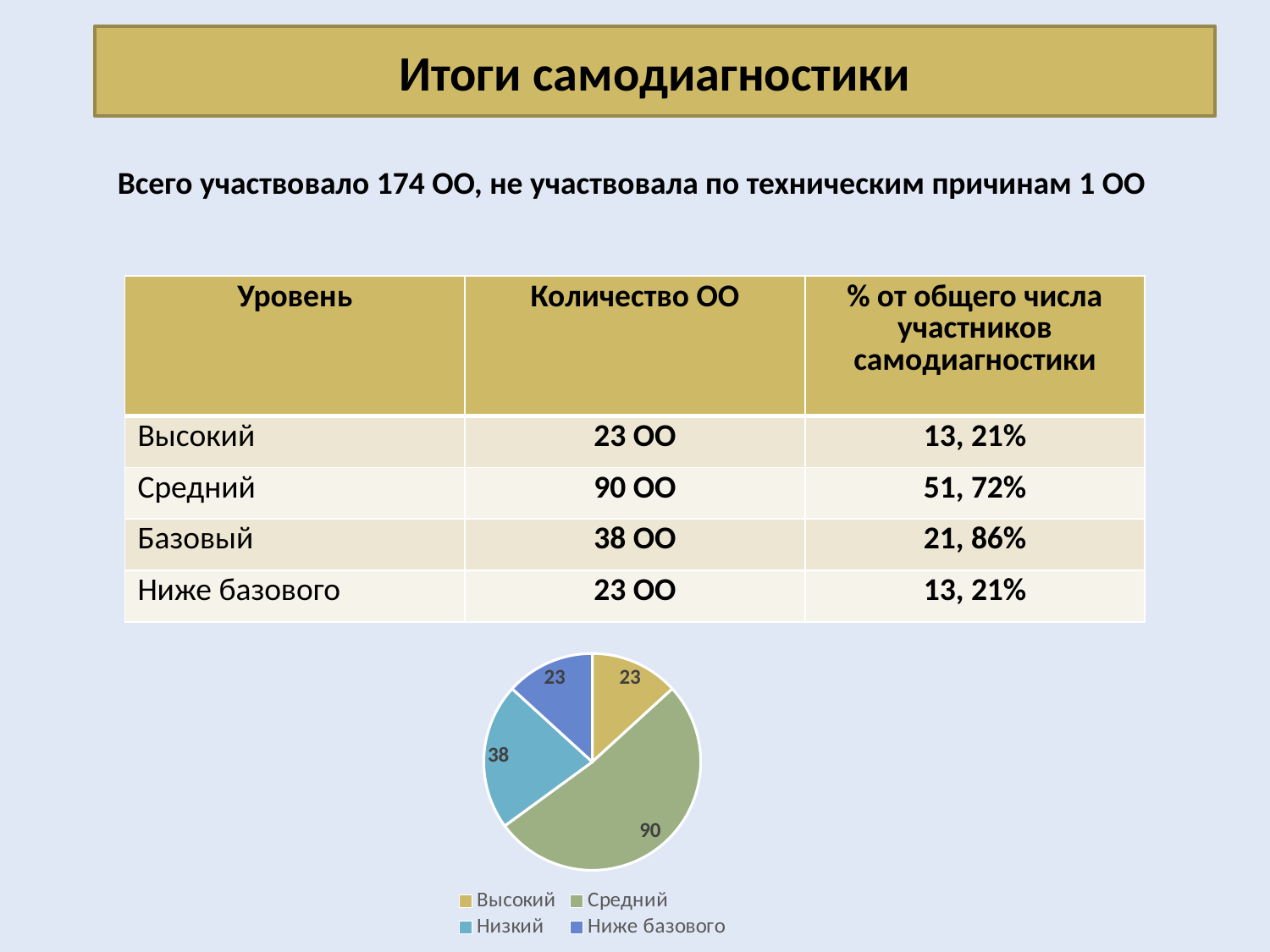
What kind of chart is shown on the slide? pie chart What colour is the Средний slice in the pie chart? green What is the difference between the Низкий and Высокий values in the pie chart? 15 What is the value of the Средний slice in the pie chart? 90 Which category has the largest slice in the pie chart? Средний What is the value of the Высокий slice in the pie chart? 23 What is the total of all slice values in the pie chart? 174 How many entries does the pie chart's legend list? 4 How many slices does the pie chart have? 4 What is the value of the Низкий slice in the pie chart? 38 What is the difference between the Средний and Низкий values in the pie chart? 52 Which is larger in the pie chart, Низкий or Ниже базового? Низкий